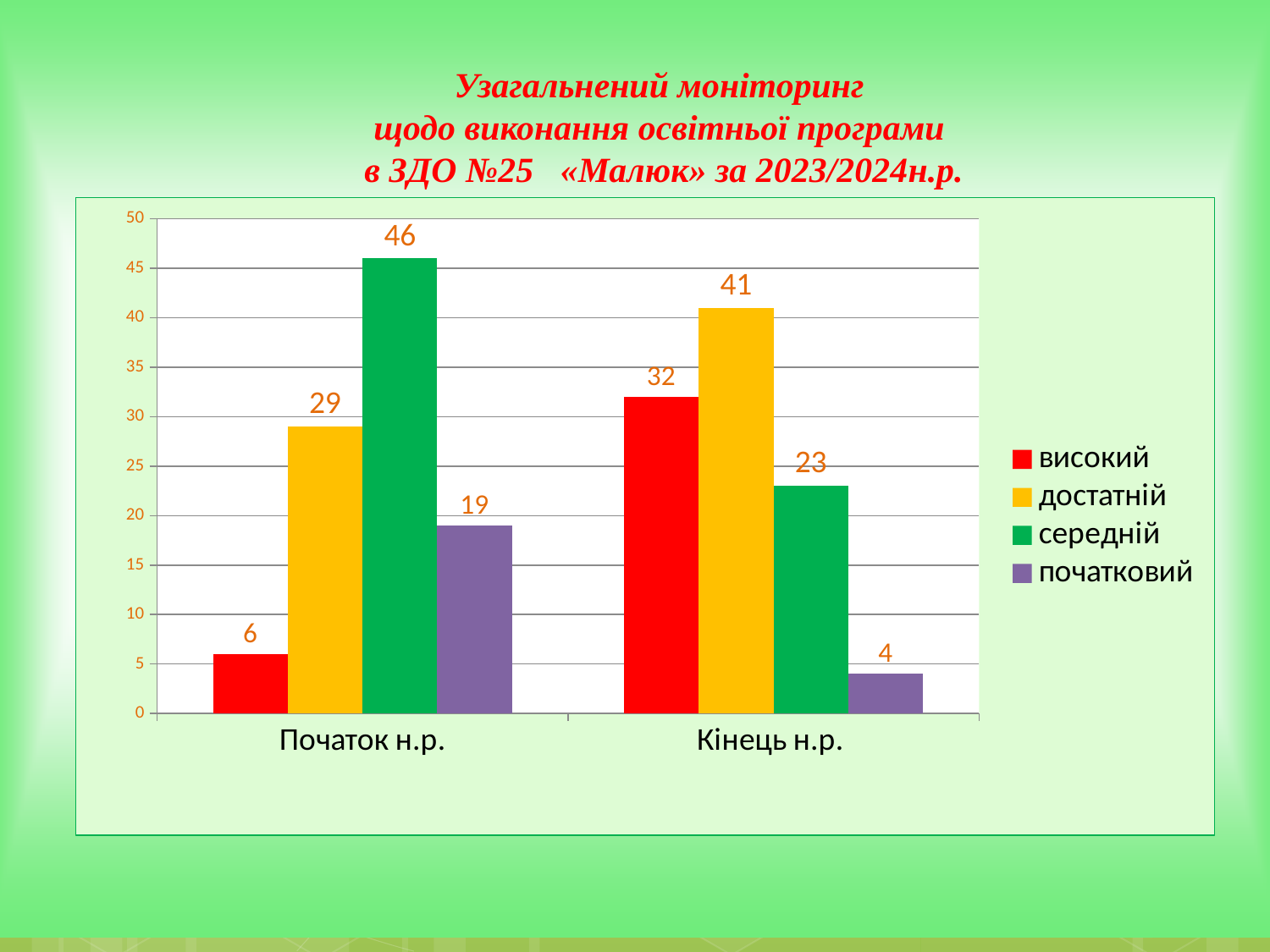
What is the value for початковий at Початок н.р.? 19 What is the value for високий at Початок н.р.? 6 How many series does the legend list? 4 Which series has the highest value at Початок н.р.? середній What kind of chart is shown on the slide? bar chart Which series has the lowest value at Кінець н.р.? початковий How many categories are shown on the x axis? 2 Which is larger: середній at Початок н.р. or середній at Кінець н.р.? Початок н.р. What is the difference between the високий values at Кінець н.р. and Початок н.р.? 26 Does the value for початковий rise or fall from Початок н.р. to Кінець н.р.? fall What is the value for достатній at Кінець н.р.? 41 What colour are the bars for достатній? yellow